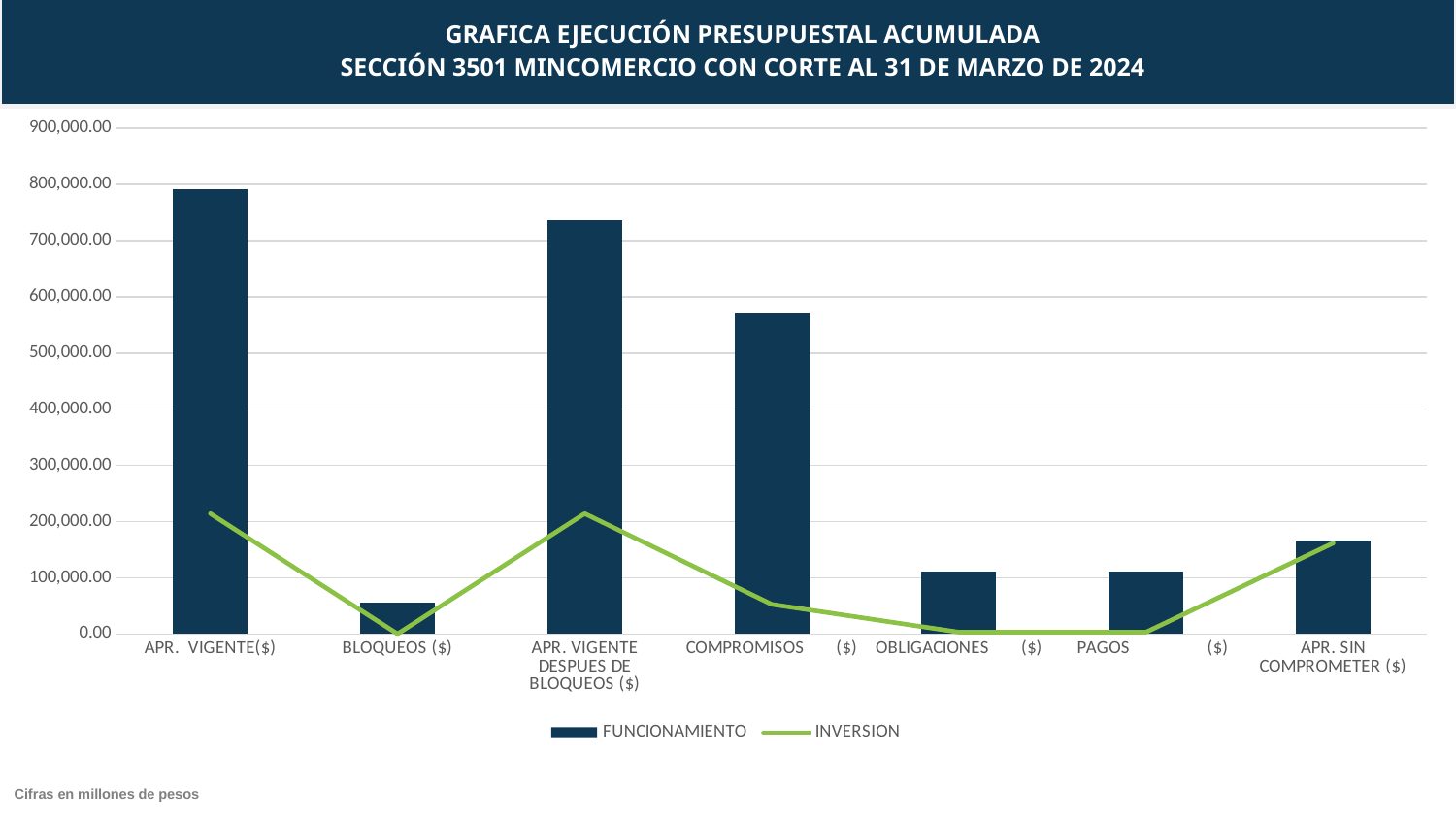
How many series does the legend list? 2 What kind of chart is this? Combined bar and line chart Which category has the lowest FUNCIONAMIENTO bar? BLOQUEOS ($) Is the FUNCIONAMIENTO value for APR. VIGENTE($) greater or less than 700,000.00? greater Which category has the highest FUNCIONAMIENTO bar? APR. VIGENTE($) For COMPROMISOS ($), which series has the larger value, FUNCIONAMIENTO or INVERSION? FUNCIONAMIENTO Is the INVERSION value for COMPROMISOS ($) greater or less than 100,000.00? less How many categories are shown on the x axis? 7 Which FUNCIONAMIENTO bar is taller, APR. VIGENTE($) or APR. VIGENTE DESPUES DE BLOQUEOS ($)? APR. VIGENTE($) Is the FUNCIONAMIENTO value for BLOQUEOS ($) greater or less than 100,000.00? less